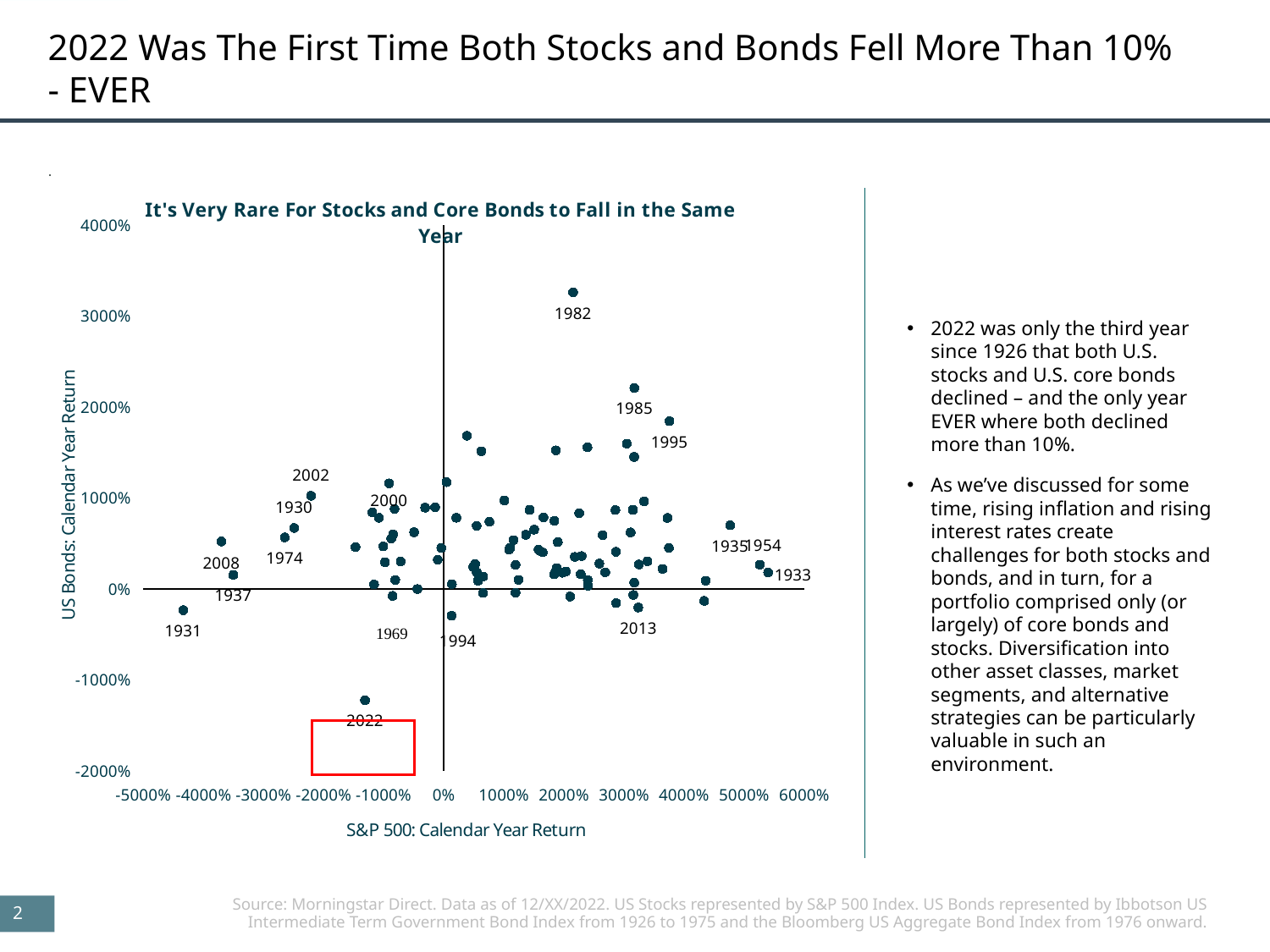
What kind of chart is shown on the slide? Scatter chart Which year has the higher US Bonds return, 1982 or 1985? 1982 Is the S&P 500 return for 1931 greater or less than -4000%? less Is the US Bonds return for 2022 greater or less than -1000%? less What is the label of the horizontal axis of the chart? S&P 500: Calendar Year Return Among the labeled years on the chart, which has the lowest US Bonds calendar year return? 2022 Is the US Bonds return for 1982 greater or less than 3000%? greater Among the labeled years on the chart, which has the highest US Bonds calendar year return? 1982 What is the title of the chart? It's Very Rare For Stocks and Core Bonds to Fall in the Same Year Which year has the higher S&P 500 return, 1931 or 2008? 2008 Among the labeled years on the chart, which has the lowest S&P 500 calendar year return? 1931